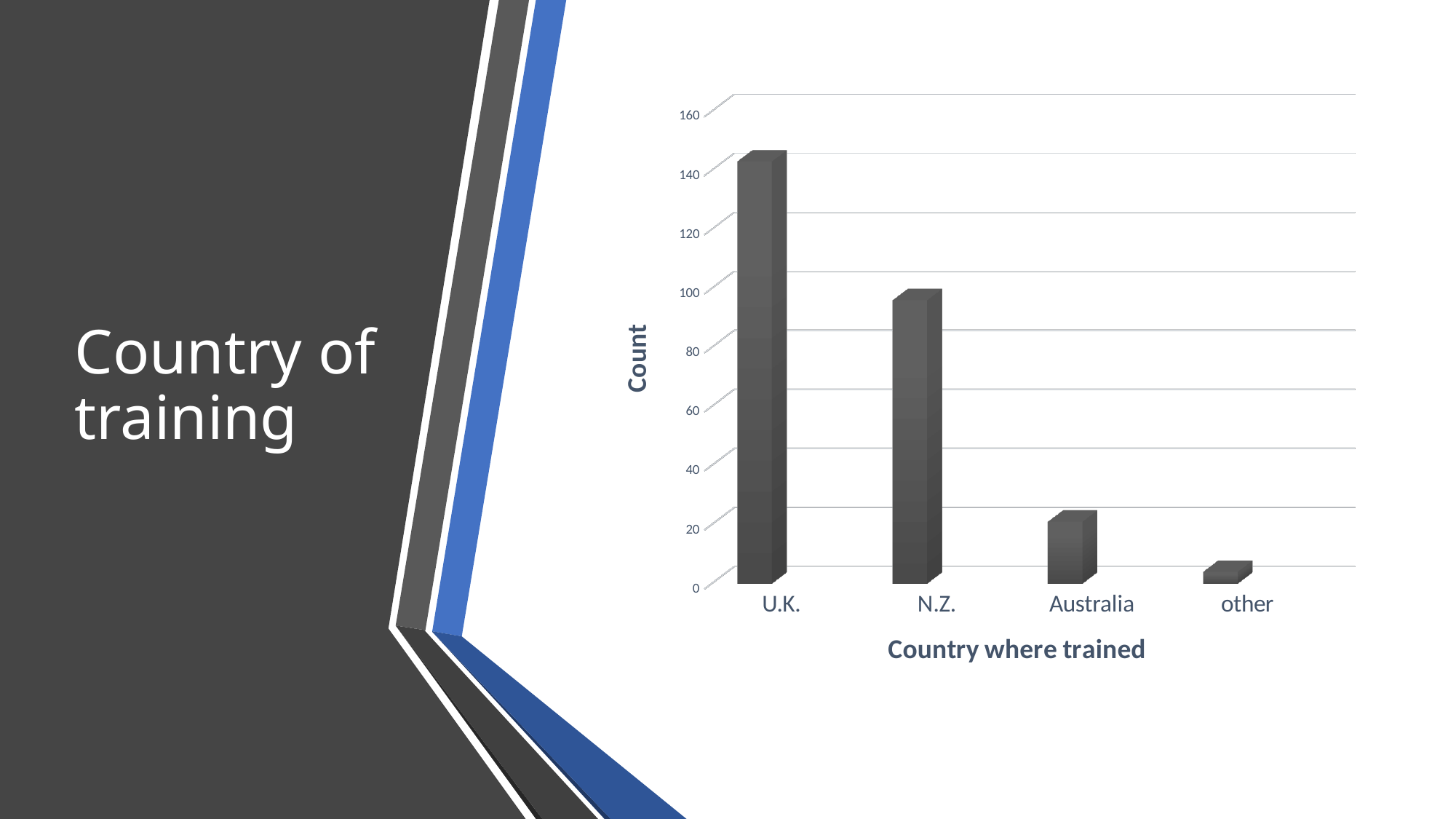
Is the value for U.K. greater or less than 120? greater What is the label of the x axis of the chart? Country where trained Which category has the lowest count in the chart? other Is the value for Australia greater or less than 40? less What kind of chart is shown on the slide? bar chart Is the value for N.Z. greater or less than 80? greater Which has a larger count, N.Z. or Australia? N.Z. Which has a larger count, U.K. or N.Z.? U.K. How many countries are shown on the x axis of the chart? 4 Which country has the highest count in the chart? U.K. Do the counts rise or fall moving from U.K. to other along the x axis? fall